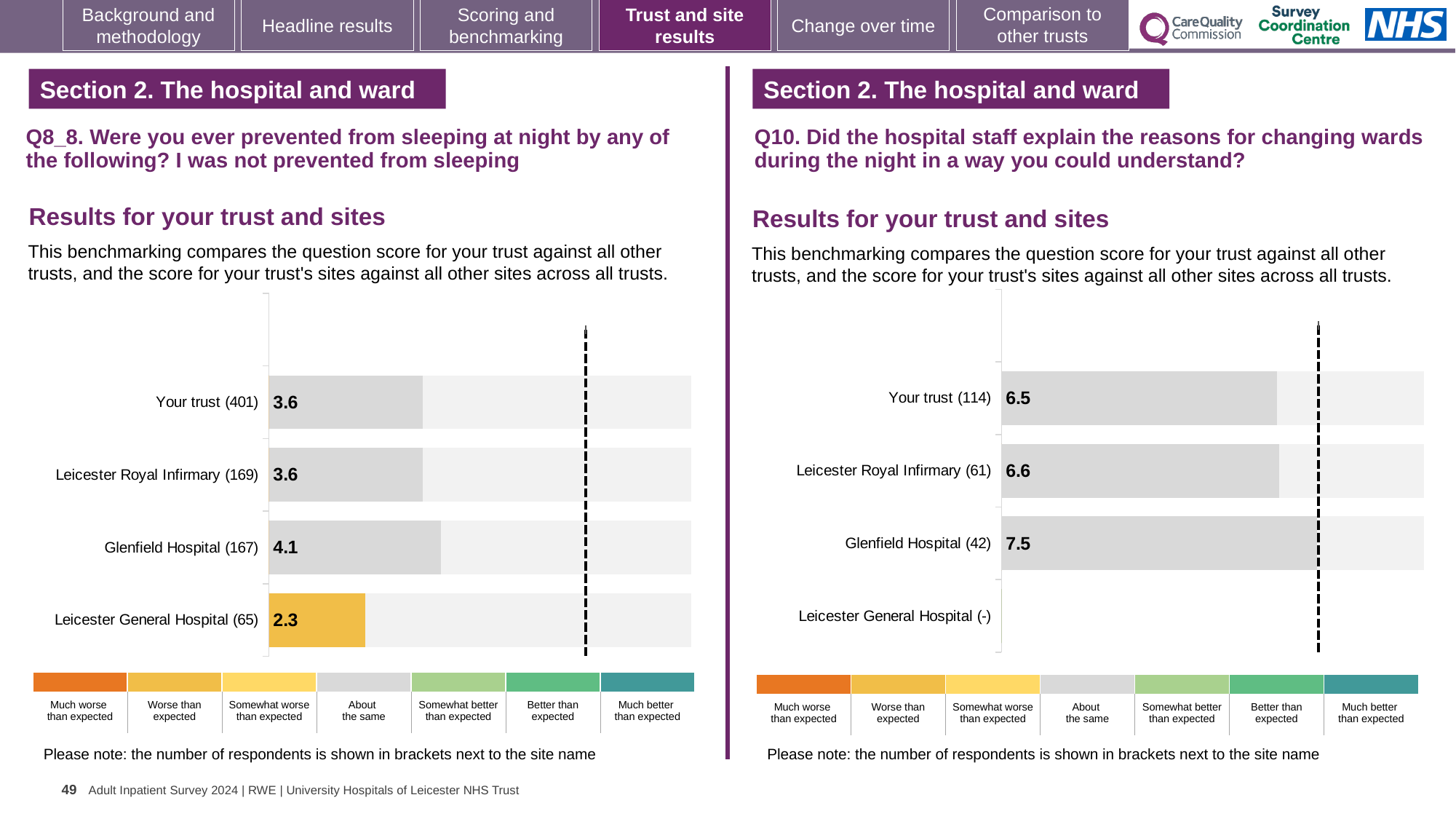
What type of chart is used on the left side of the slide for Q8_8? Bar chart In the Q10 chart on the right, how many rows (trust and sites) are listed on the vertical axis? 4 In the Q8_8 chart on the left, which site has the lowest score? Leicester General Hospital In the Q8_8 chart on the left, what is the score for Glenfield Hospital? 4.1 In the Q10 chart on the right, what is the difference between the scores for Glenfield Hospital and Leicester Royal Infirmary? 0.9 In the Q8_8 chart on the left, how many respondents are shown for Your trust? 401 In the Q8_8 chart on the left, what is the score for Leicester General Hospital? 2.3 In the Q10 chart on the right, what is the score for Glenfield Hospital? 7.5 In the Q8_8 chart on the left, which site has the highest score? Glenfield Hospital In the Q8_8 chart on the left, what is the difference between the scores for Glenfield Hospital and Leicester General Hospital? 1.8 In the Q10 chart on the right, which site has the highest score? Glenfield Hospital In the Q10 chart on the right, what is the score for Your trust? 6.5